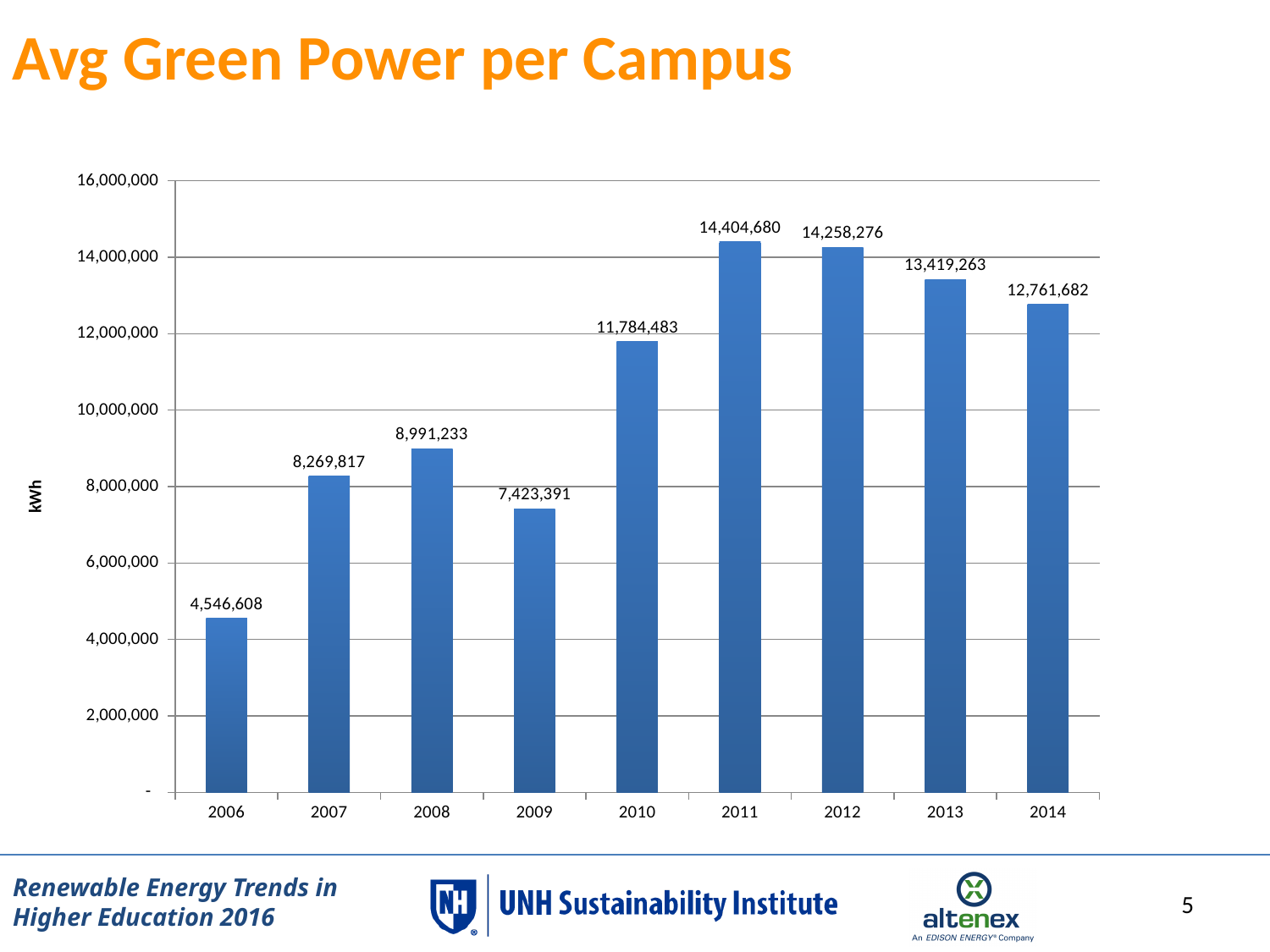
What is the value for 2014? 12,761,682 What type of chart is shown on the slide? bar chart Is the value for 2008 greater or less than 10,000,000? less Which year has the larger value, 2009 or 2010? 2010 What value is shown for 2006? 4,546,608 Which year has the highest average green power per campus? 2011 What is the difference between the 2011 and 2012 values? 146,404 How many years are shown on the x axis? 9 What unit is shown on the y axis label? kWh How much higher is the 2014 value than the 2006 value? 8,215,074 Which year has the lowest average green power per campus? 2006 What is the average green power per campus in 2010? 11,784,483